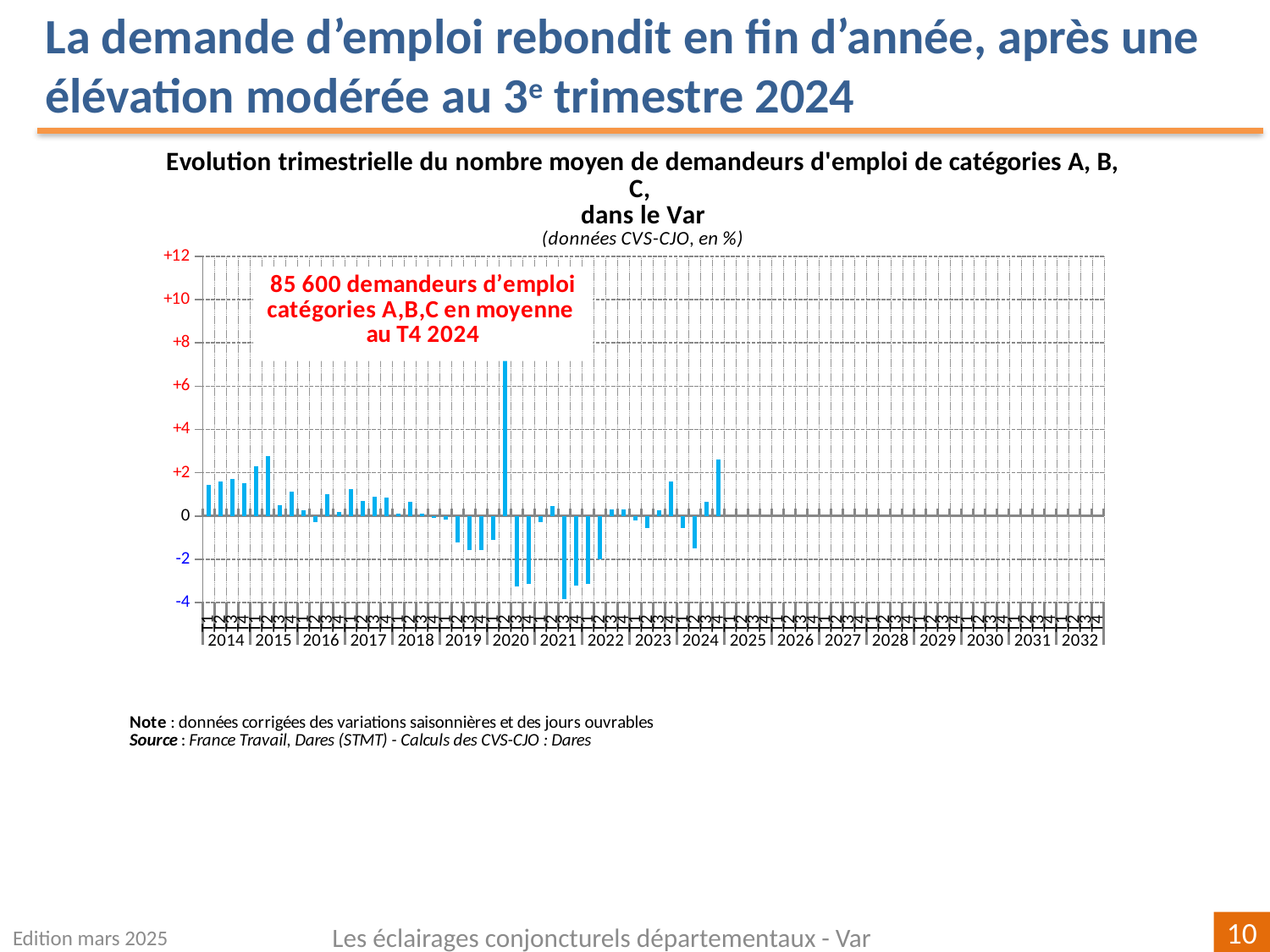
Which is larger: the tallest bar in 2020 or the tallest bar in 2015? the tallest bar in 2020 According to the text box on the chart, how many demandeurs d'emploi catégories A,B,C were there on average in T4 2024? 85 600 In what unit are the chart's data expressed, according to the subtitle? en % In which year does the tallest bar of the chart appear? 2020 Is the value of the last bar plotted (end of 2024) greater or less than +2? greater Is the value of the tallest bar (in 2020) greater or less than +6? greater How many years are labelled on the horizontal axis? 19 Is the value of the lowest bar in 2021 greater or less than -2? less What kind of chart is shown on the slide? bar chart What is the lowest tick value shown on the vertical axis? -4